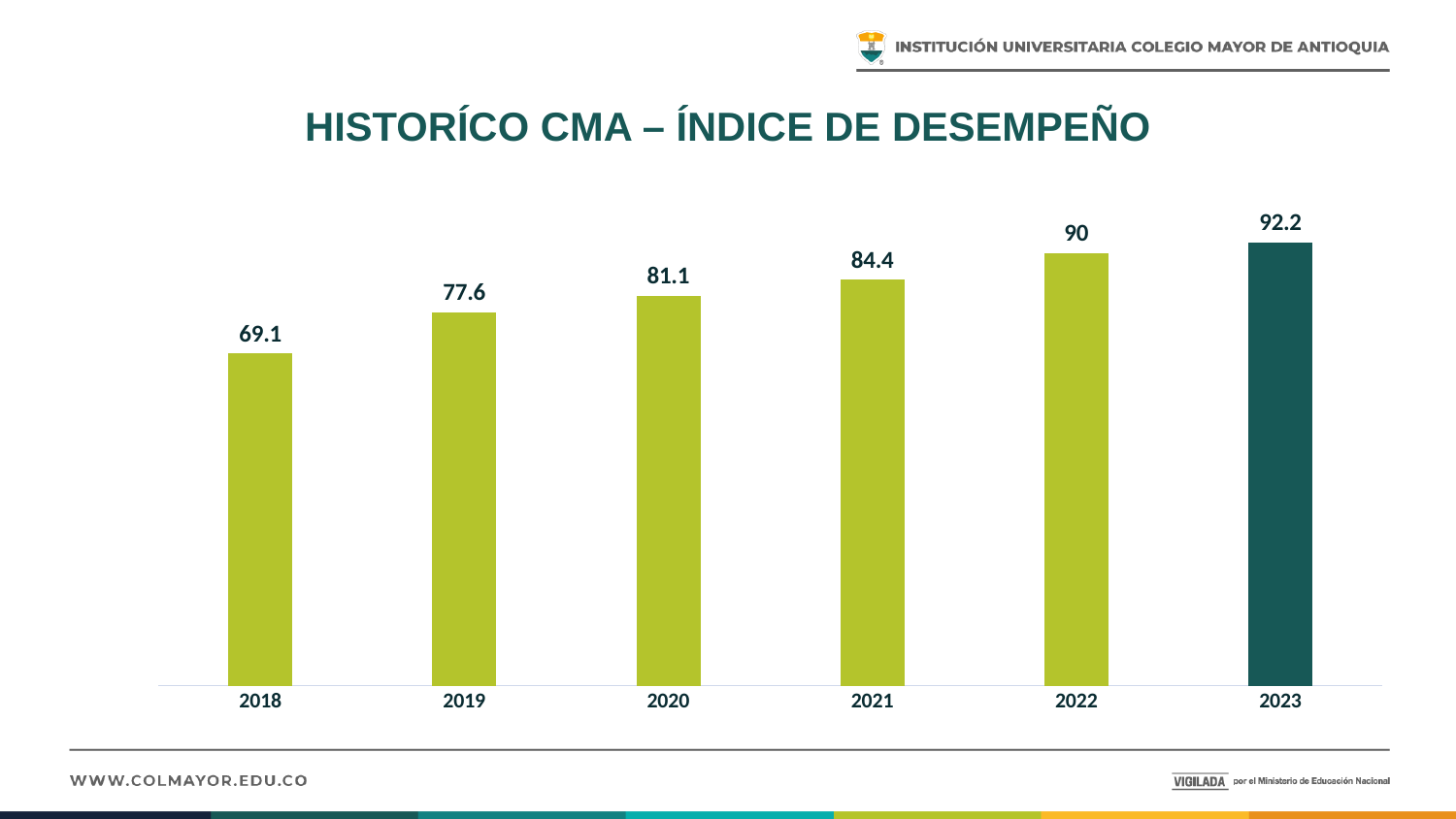
Which bar is shown in a different colour from the others? 2023 How many years are shown on the x axis? 6 Which year has the lowest value? 2018 Do the values rise or fall from 2018 to 2023? rise What kind of chart is this? bar chart What is the difference between the values for 2022 and 2021? 5.6 What is the value for 2023? 92.2 What is the value for 2018? 69.1 What is the value for 2021? 84.4 Which year has the highest value? 2023 What is the difference between the values for 2023 and 2018? 23.1 Which is larger, the value for 2019 or the value for 2020? 2020